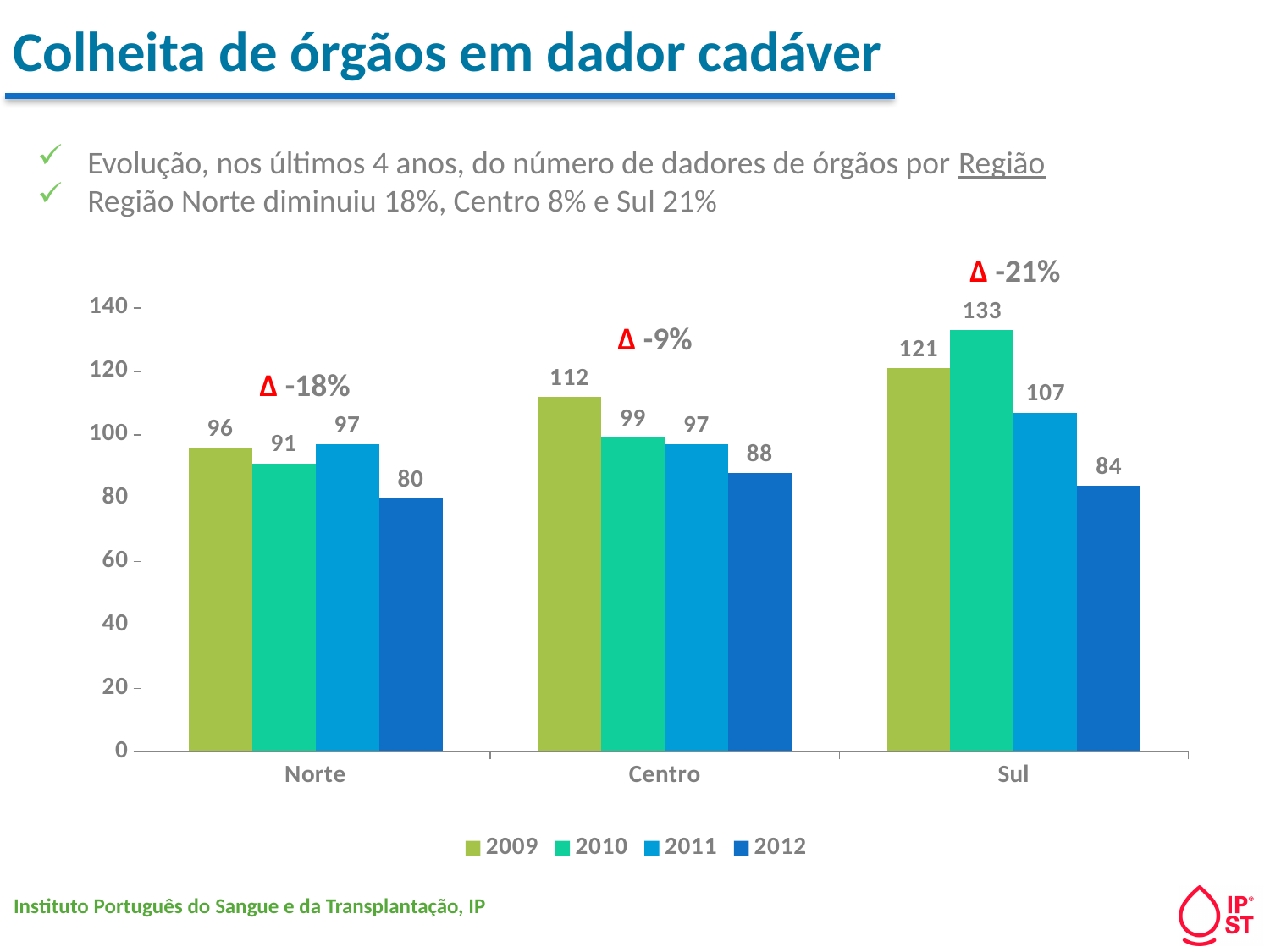
Which region has the highest value in 2011? Sul What is the value for Centro in 2009? 112 What is the difference between the 2009 and 2012 values for Sul? 37 What kind of chart is shown on the slide? bar chart What percentage change is annotated above the Centro group? Δ -9% What is the value for Sul in 2010? 133 How many series does the legend list? 4 Is the value for Sul in 2011 greater or less than 100? greater What is the value for Norte in 2012? 80 Which region has the lowest value in 2012? Norte Which is larger, the 2010 value for Norte or the 2010 value for Centro? Centro How many regions are shown on the x axis? 3